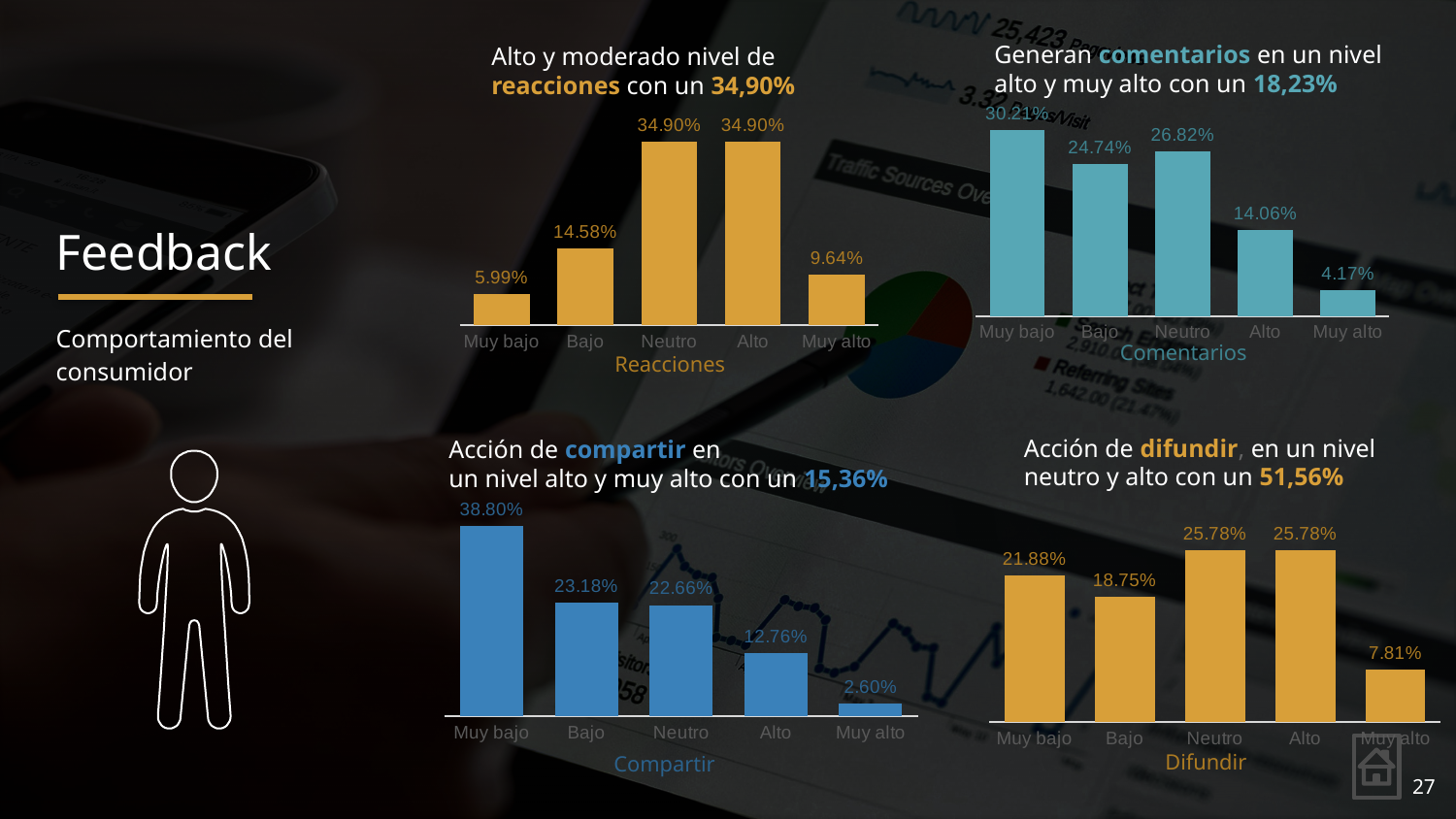
How many categories are shown in the Difundir chart? 5 In the Reacciones chart, what is the value for Bajo? 14.58% In the Compartir chart, which category has the lowest value? Muy alto In the Comentarios chart, what is the difference between the values for Muy bajo and Muy alto? 26.04% In the Compartir chart, do the values rise or fall from Muy bajo to Muy alto? Fall How many charts are shown on the slide? 4 In the Difundir chart, what is the value for Muy alto? 7.81% In the Reacciones chart, what is the value for Muy alto? 9.64% In the Compartir chart, which is larger, the value for Muy bajo or the value for Bajo? Muy bajo In the Difundir chart, what is the difference between the values for Neutro and Bajo? 7.03% What kind of chart is the Reacciones chart? Bar chart In the Comentarios chart, which category has the highest value? Muy bajo